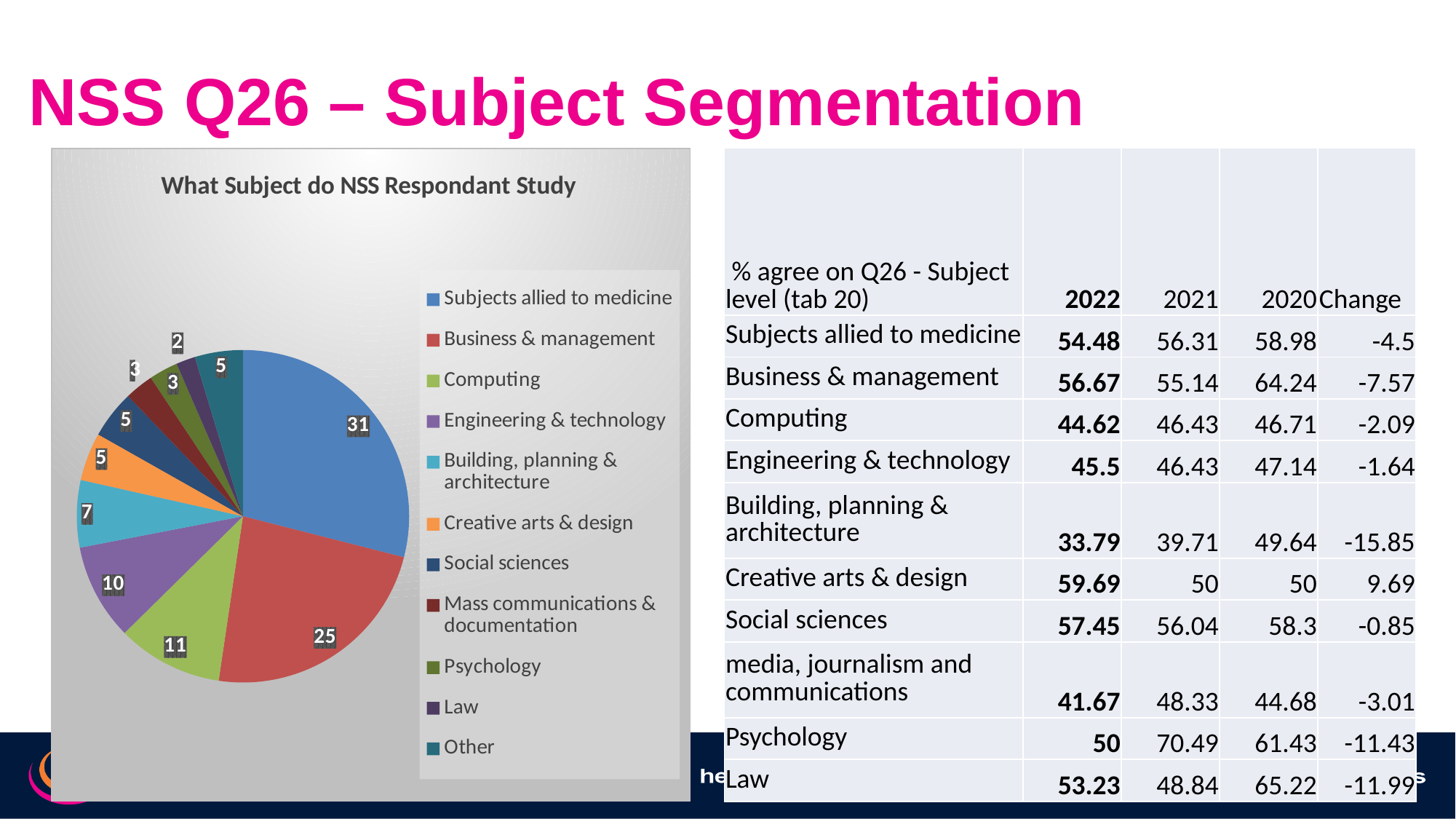
What is the value for Business & management in the pie chart? 25 Which category has the smallest slice in the pie chart? Law What is the value for Computing in the pie chart? 11 What kind of chart is shown on the slide? pie chart What is the value for Subjects allied to medicine in the pie chart? 31 What is the difference between the values for Subjects allied to medicine and Business & management in the pie chart? 6 Which category has the largest slice in the pie chart? Subjects allied to medicine What is the title of the pie chart? What Subject do NSS Respondant Study Which is larger in the pie chart, Computing or Engineering & technology? Computing How many categories does the pie chart legend list? 11 What is the value for Building, planning & architecture in the pie chart? 7 What is the value for Engineering & technology in the pie chart? 10